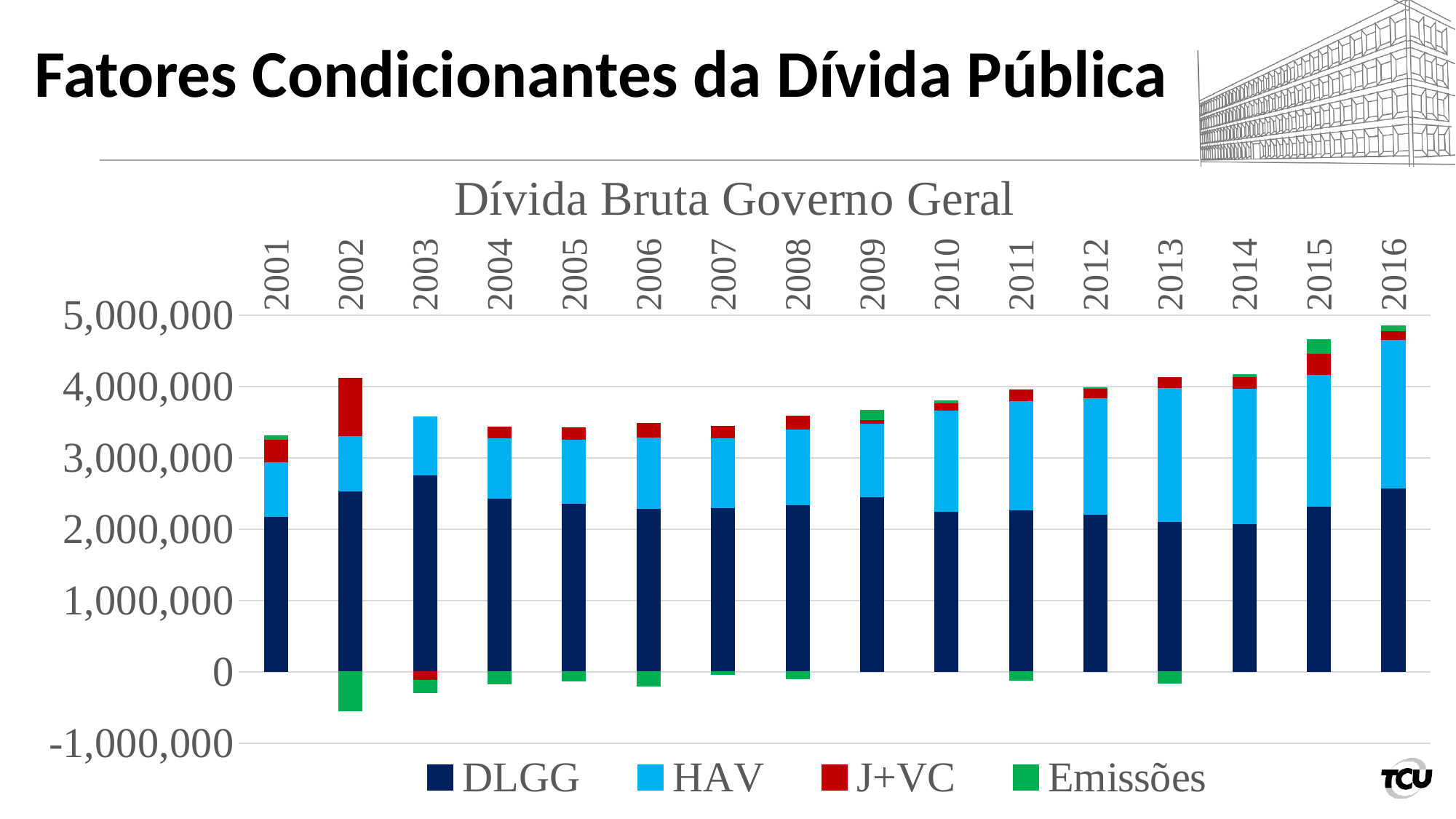
Is the DLGG value for 2003 greater or less than 2,000,000? greater What is the title of the chart? Dívida Bruta Governo Geral Is the top of the stacked bar for 2003 greater or less than 4,000,000? less Is the top of the stacked bar for 2016 greater or less than 5,000,000? less What kind of chart is shown on the slide? Stacked bar chart Which colour represents the Emissões series? Green Do the stacked bar totals generally rise or fall from 2009 to 2016? rise How many series does the legend list? 4 Which year has the larger DLGG segment, 2001 or 2003? 2003 Which year has the tallest stacked bar? 2016 How many years are shown on the x axis? 16 Which year has the largest DLGG segment? 2003